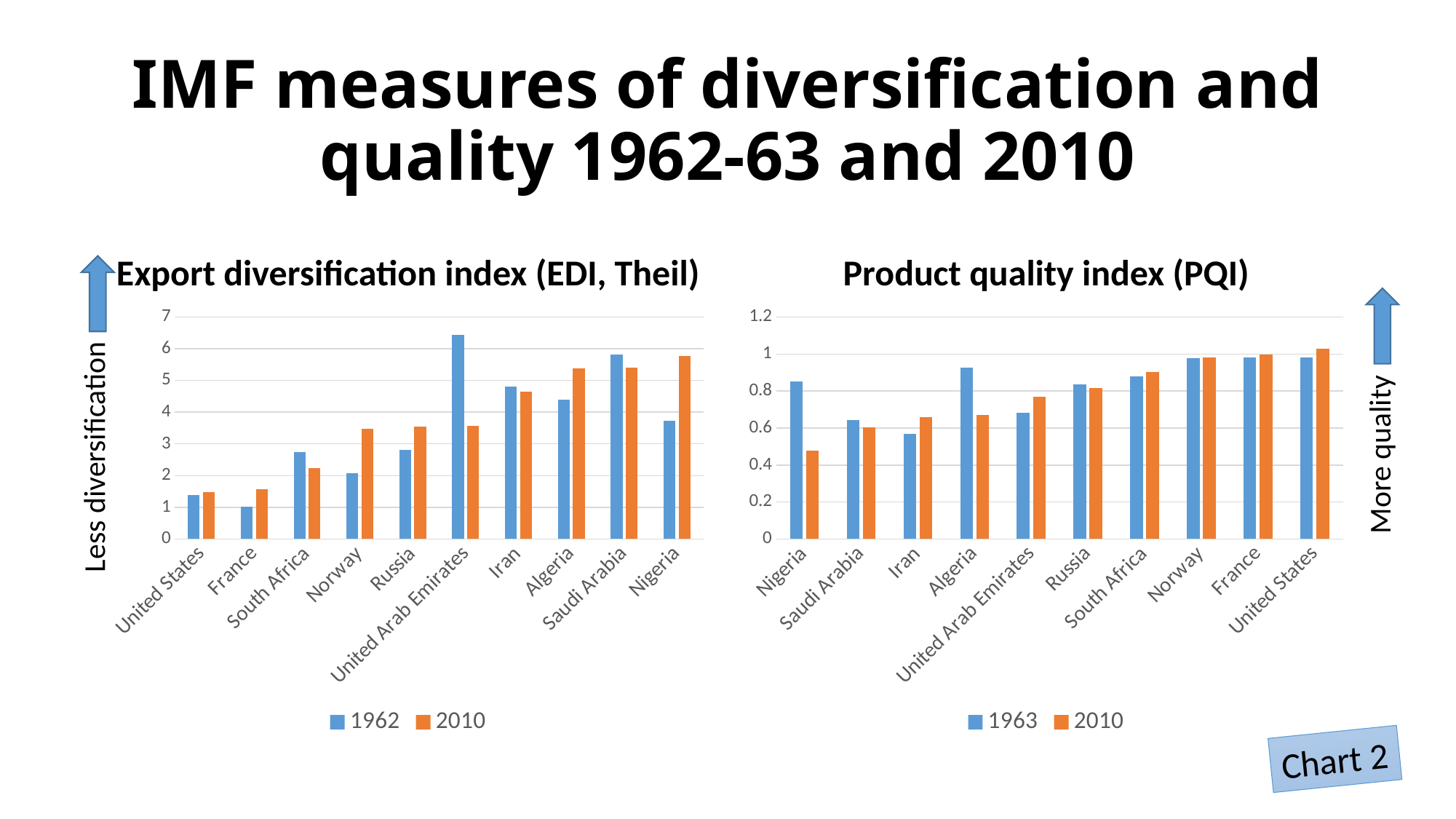
On the Export diversification index (EDI, Theil) chart, which country has the highest 2010 value? Nigeria On the Export diversification index (EDI, Theil) chart, which country has the lowest 1962 value? France On the Product quality index (PQI) chart, for Algeria, which is larger: the 1963 value or the 2010 value? 1963 On the Export diversification index (EDI, Theil) chart, is the 2010 value for Norway greater or less than 3? greater On the Export diversification index (EDI, Theil) chart, for Nigeria, which is larger: the 1962 value or the 2010 value? 2010 On the Export diversification index (EDI, Theil) chart, is the 1962 value for United Arab Emirates greater or less than 6? greater On the Export diversification index (EDI, Theil) chart, which country has the highest 1962 value? United Arab Emirates On the Product quality index (PQI) chart, which country has the lowest 2010 value? Nigeria On the Product quality index (PQI) chart, which country has the lowest 1963 value? Iran On the Product quality index (PQI) chart, is the 2010 value for Nigeria greater or less than 0.6? less How many countries are shown on the Product quality index (PQI) chart? 10 How many series does the legend of the Export diversification index (EDI, Theil) chart list? 2